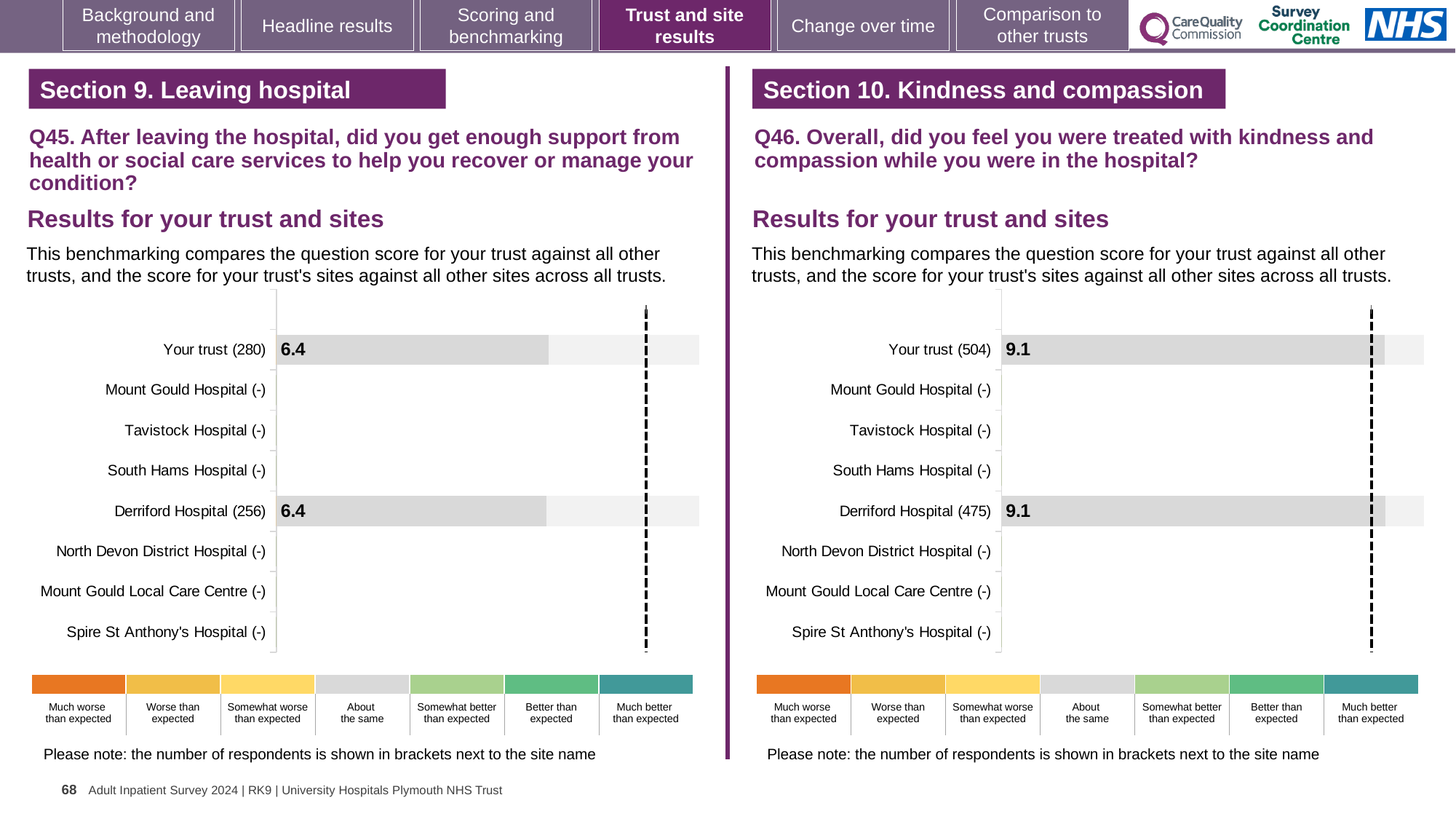
How many site/trust rows are listed on the Q45 chart (left)? 8 On the Q45 chart (left), what is the score for Derriford Hospital? 6.4 On the Q45 chart (left), what is the difference between the score for Your trust and the score for Derriford Hospital? 0 On the Q46 chart (right), how many respondents are shown in brackets for Derriford Hospital? 475 On the Q45 chart (left), how many respondents are shown in brackets for Derriford Hospital? 256 On the Q45 chart (left), what is the score for Your trust? 6.4 On the Q46 chart (right), what is the score for Your trust? 9.1 On the Q46 chart (right), how many categories does the colour legend below the chart list? 7 On the Q45 chart (left), how many rows have a plotted bar with a score? 2 On the Q46 chart (right), what is the score for Derriford Hospital? 9.1 On the Q46 chart (right), how many respondents are shown in brackets for Your trust? 504 What kind of chart is used on the Q46 chart (right)? Bar chart